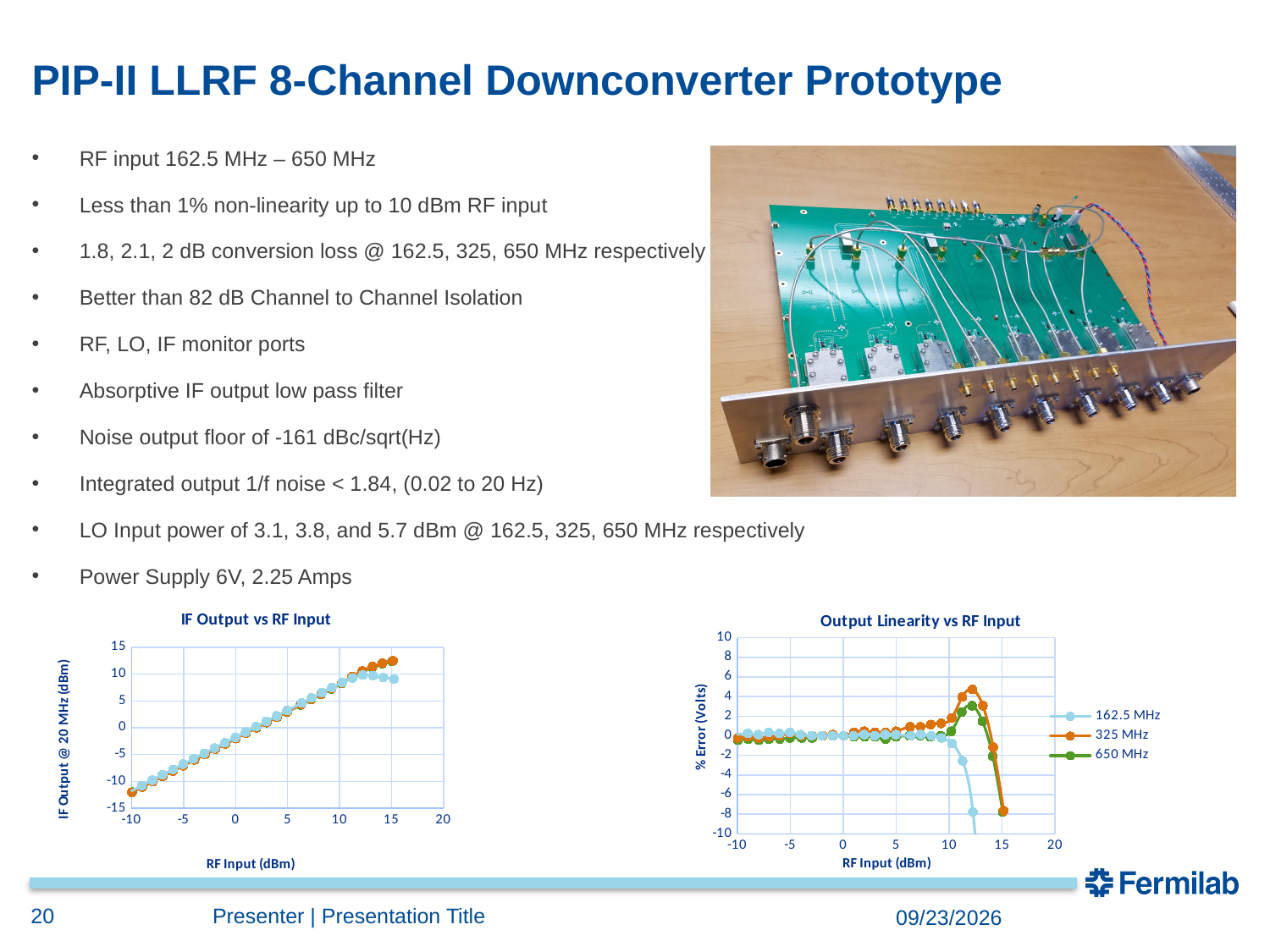
In the 'Output Linearity vs RF Input' chart, does the 162.5 MHz series rise or fall as RF input goes from 10 to 12 dBm? fall In the 'IF Output vs RF Input' chart, is the IF output at an RF input of 10 dBm greater or less than 5? greater Which series in the 'Output Linearity vs RF Input' chart reaches the highest % error? 325 MHz In the 'Output Linearity vs RF Input' chart, which series is drawn in green? 650 MHz In the 'Output Linearity vs RF Input' chart, is the peak % error for 325 MHz greater or less than 2? greater What is the y-axis title of the 'IF Output vs RF Input' chart? IF Output @ 20 MHz (dBm) In the 'Output Linearity vs RF Input' chart, is the % error for 162.5 MHz at an RF input of 12 dBm greater or less than -4? less How many series does the legend of the 'Output Linearity vs RF Input' chart list? 3 What kind of chart is the 'IF Output vs RF Input' chart? line chart In the 'IF Output vs RF Input' chart, do the values rise or fall as RF input increases from -10 to 10 dBm? rise